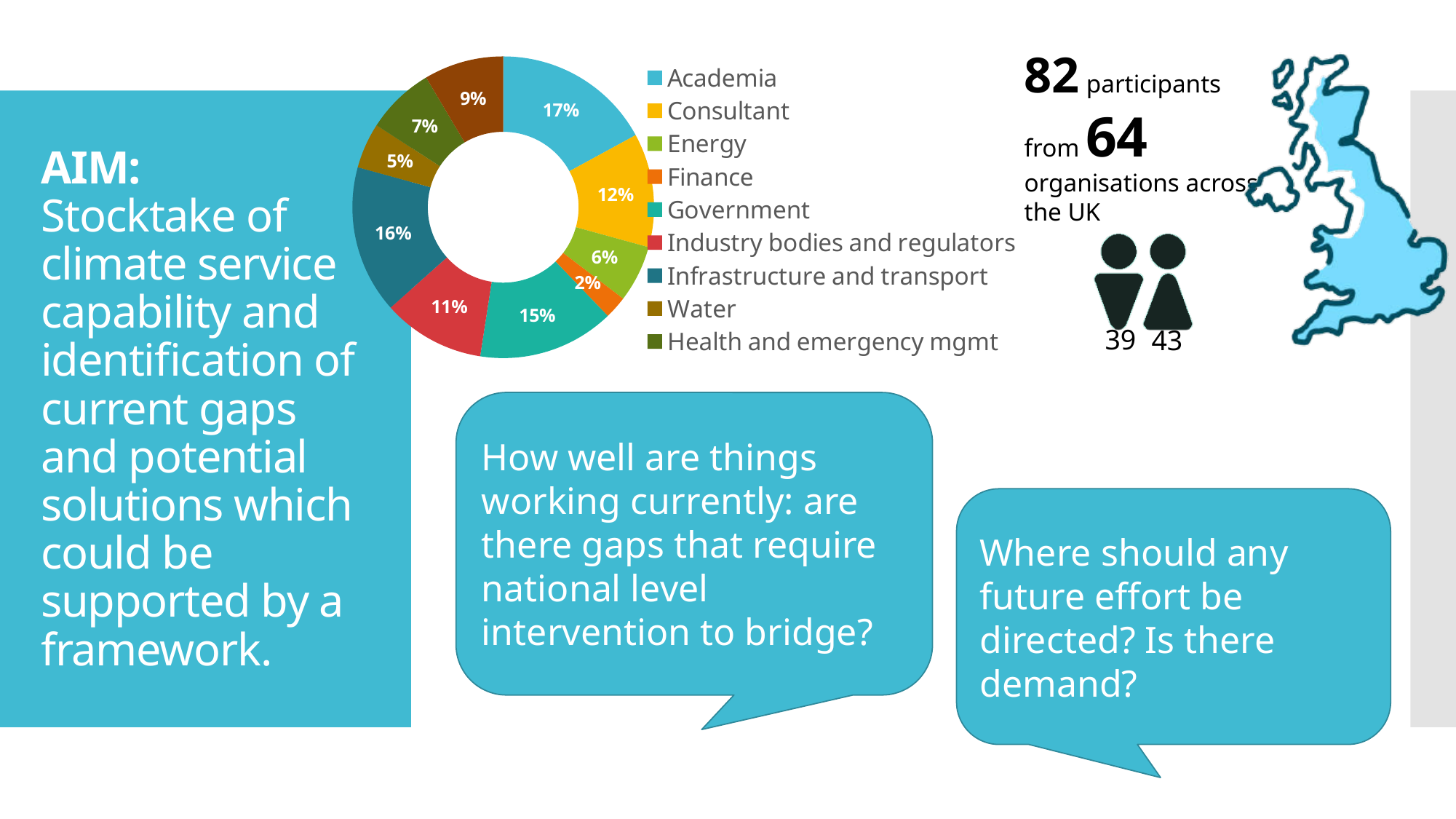
What is the difference in percentage points between Academia and Consultant in the pie chart? 5 What is the value for Industry bodies and regulators in the pie chart? 11% What type of chart is shown on the slide? doughnut chart How many entries does the legend of the pie chart list? 9 Which category has the smallest share in the pie chart? Finance What share does Government hold in the pie chart? 15% Which category has the largest share in the pie chart? Academia What percentage of participants are from Academia in the pie chart? 17% What percentage is shown for Finance in the pie chart? 2% What is the value shown for Infrastructure and transport in the pie chart? 16% What colour is the Consultant slice in the pie chart? yellow Which is larger in the pie chart, Energy or Water? Energy